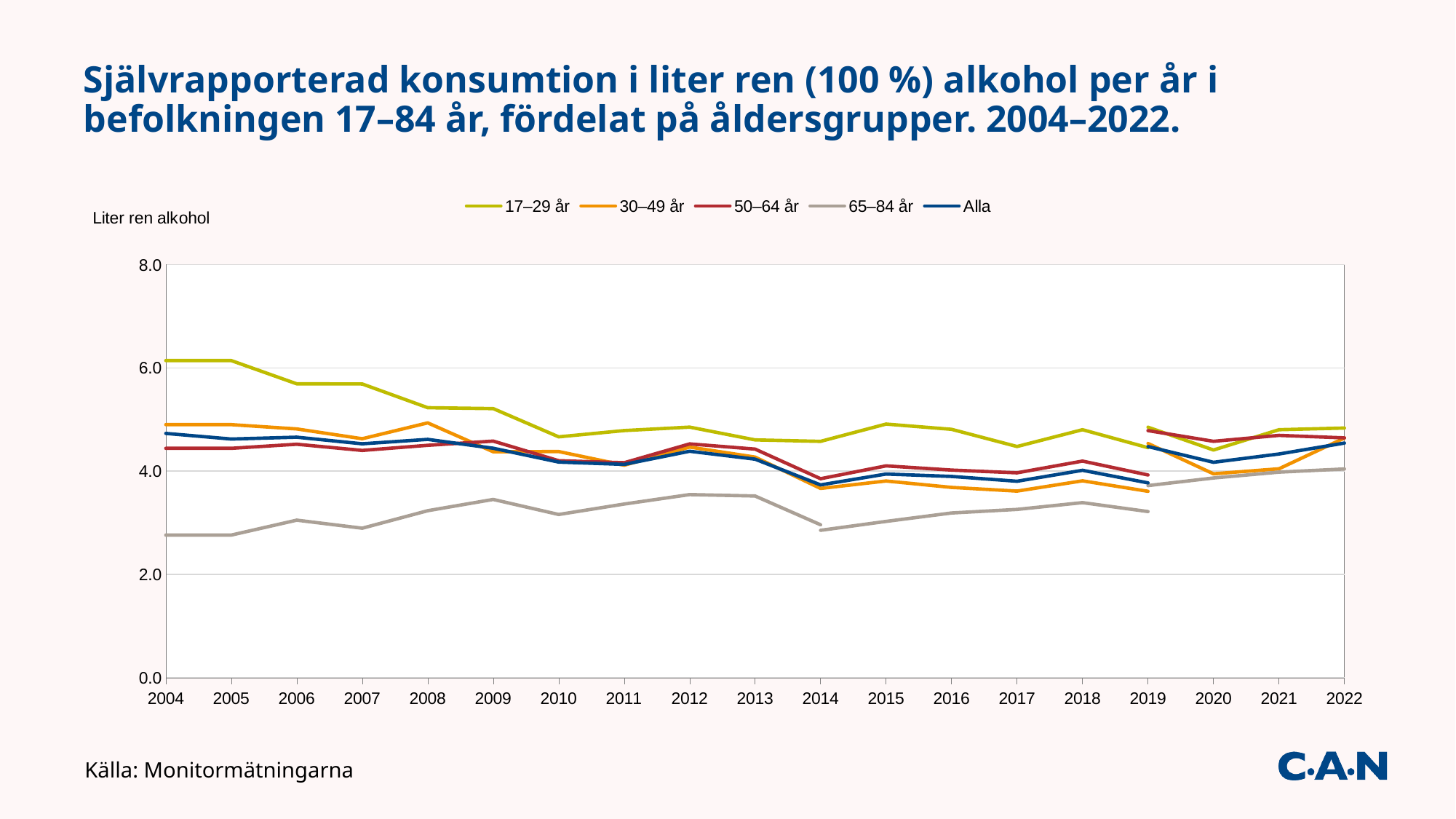
How many years are labelled on the x axis? 19 What is the label on the y axis of the chart? Liter ren alkohol How many series does the legend list? 5 Is the value for 30–49 år in 2014 greater or less than 4.0? less What kind of chart is shown on the slide? Line chart Is the value for 17–29 år in 2006 greater or less than 6.0? less Which age group has the lowest value in 2004? 65–84 år Is the value for 65–84 år in 2004 greater or less than 2.0? greater Which age group has the highest value in 2004? 17–29 år Is the value for 17–29 år in 2004 larger in 2004 or in 2022? 2004 Which age group has the lowest value in 2022? 65–84 år Does the value for 17–29 år rise or fall from 2004 to 2010? Fall